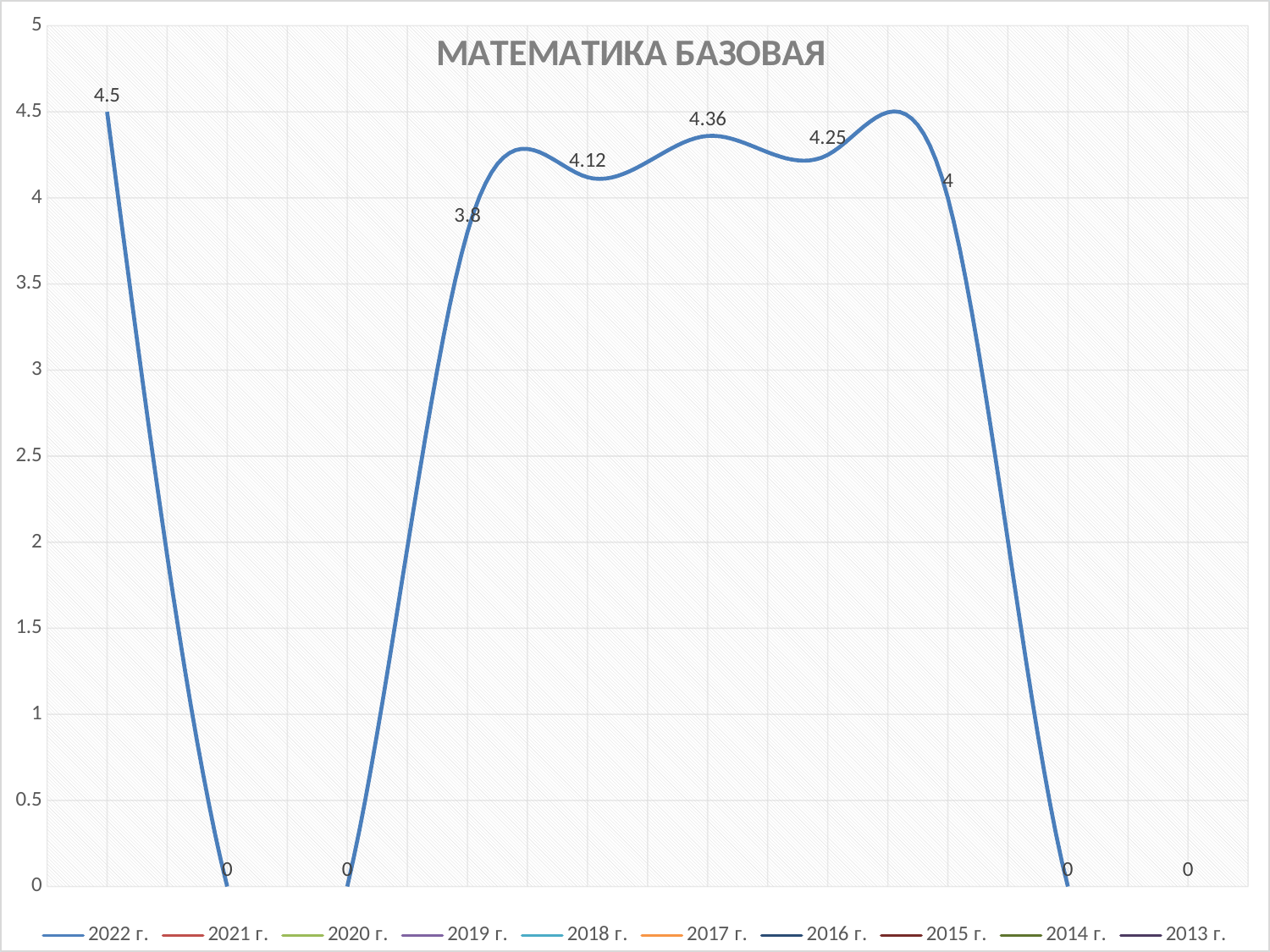
How many entries does the legend list? 10 How many data points on the line have a value of 0? 4 What is the value of the last (rightmost) data point on the line? 0 What kind of chart is shown on the slide? line chart Is the value of the first data point greater or less than 4? greater What is the title of the chart? МАТЕМАТИКА БАЗОВАЯ What is the value of the first (leftmost) data point on the line? 4.5 What is the highest labelled value on the line? 4.5 What is the difference between the points labelled 4.36 and 4.12? 0.24 What is the lowest labelled value on the line? 0 How many data points are labelled on the line? 10 What is the difference between the highest labelled value (4.5) and the point labelled 4? 0.5